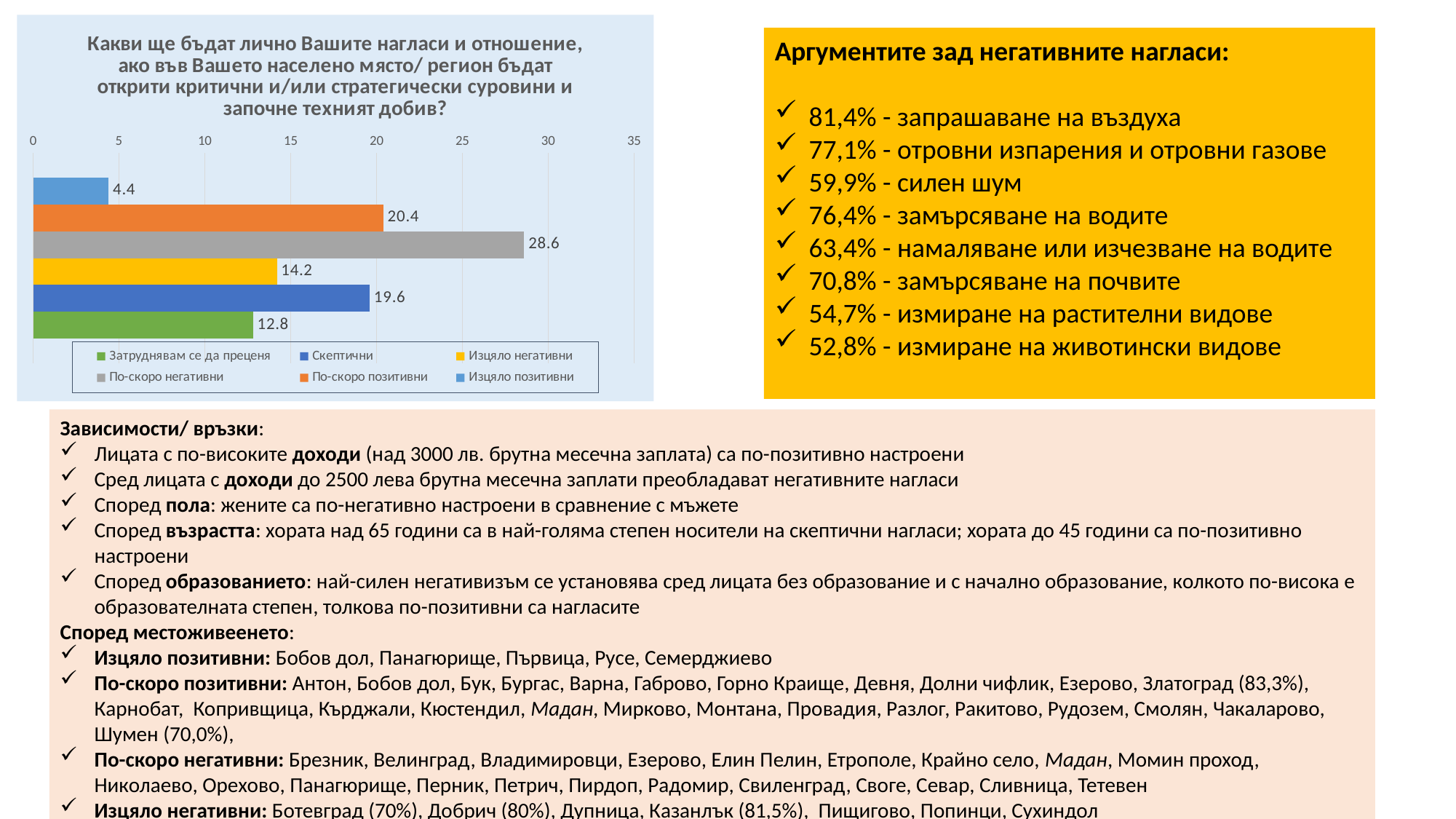
Which category has the lowest value in the chart? Изцяло позитивни What is the value for "Затруднявам се да преценя"? 12.8 Which is larger, the value for "По-скоро позитивни" or the value for "Скептични"? По-скоро позитивни What is the value for "Изцяло позитивни"? 4.4 What is the difference between the values for "По-скоро негативни" and "Изцяло негативни"? 14.4 What is the value for "Скептични"? 19.6 What colour is the bar for "По-скоро позитивни"? orange Which category has the highest value in the chart? По-скоро негативни What type of chart is shown on the slide? bar chart How many series does the chart legend list? 6 Is the value for "Изцяло негативни" greater or less than 15? less What is the value for "По-скоро негативни"? 28.6